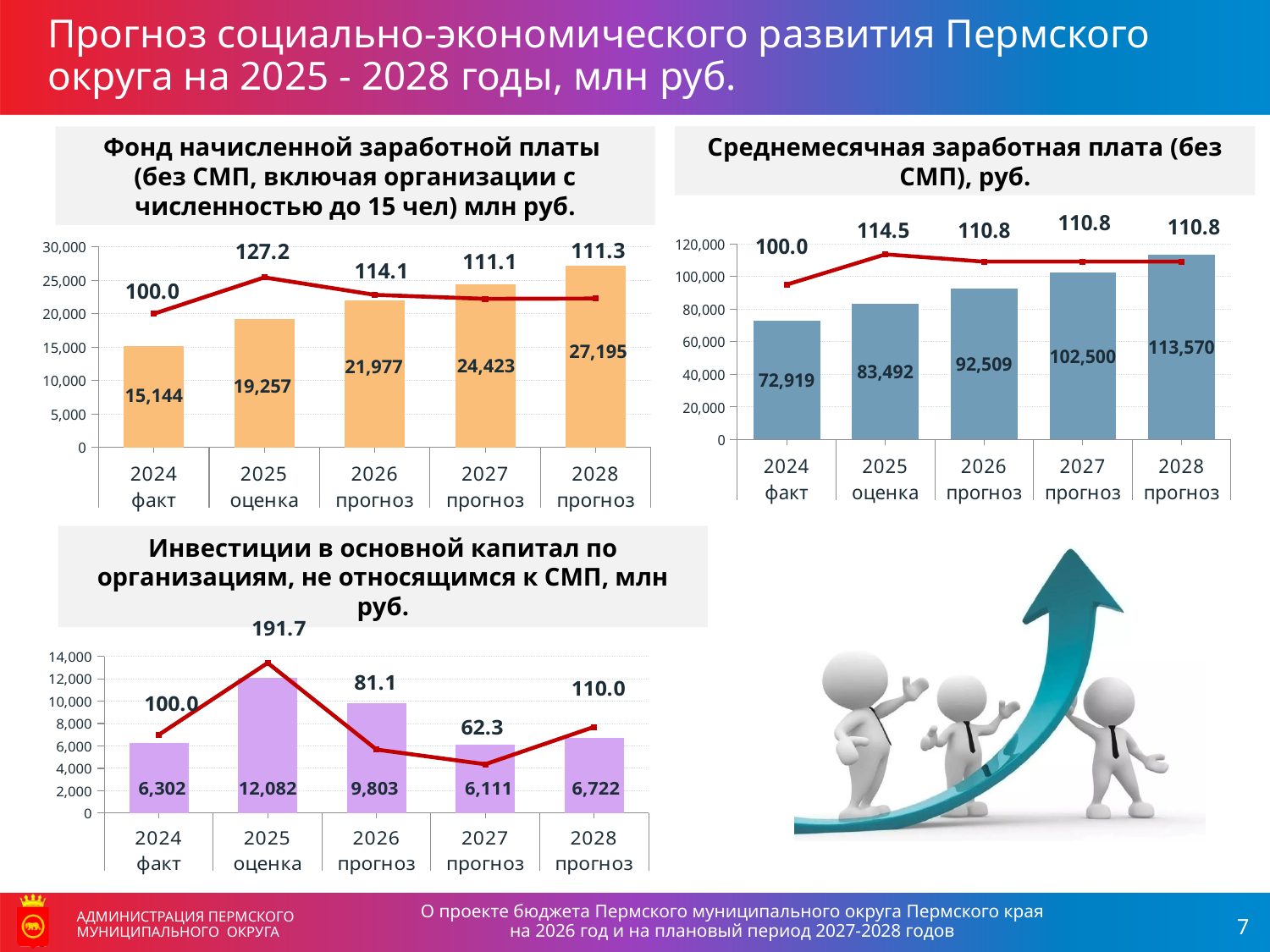
In the chart 'Фонд начисленной заработной платы', what is the bar value for 2026 прогноз? 21,977 In the chart 'Инвестиции в основной капитал', which year has the lowest bar value? 2027 прогноз In the chart 'Инвестиции в основной капитал', what is the bar value for 2025 оценка? 12,082 In the chart 'Фонд начисленной заработной платы', what is the difference between the bar values for 2028 прогноз and 2024 факт? 12,051 In the chart 'Инвестиции в основной капитал', what is the line value for 2027 прогноз? 62.3 How many year categories are shown on the x axis of the chart 'Фонд начисленной заработной платы'? 5 In the chart 'Среднемесячная заработная плата (без СМП), руб.', do the bar values rise or fall from 2024 to 2028? rise In the chart 'Среднемесячная заработная плата (без СМП), руб.', what is the line value for 2025 оценка? 114.5 In the chart 'Инвестиции в основной капитал', which is larger: the bar value for 2026 прогноз or for 2028 прогноз? 2026 прогноз In the chart 'Среднемесячная заработная плата (без СМП), руб.', which year has the highest bar value? 2028 прогноз In the chart 'Среднемесячная заработная плата (без СМП), руб.', what is the bar value for 2027 прогноз? 102,500 In the chart 'Фонд начисленной заработной платы', what is the line value for 2025 оценка? 127.2